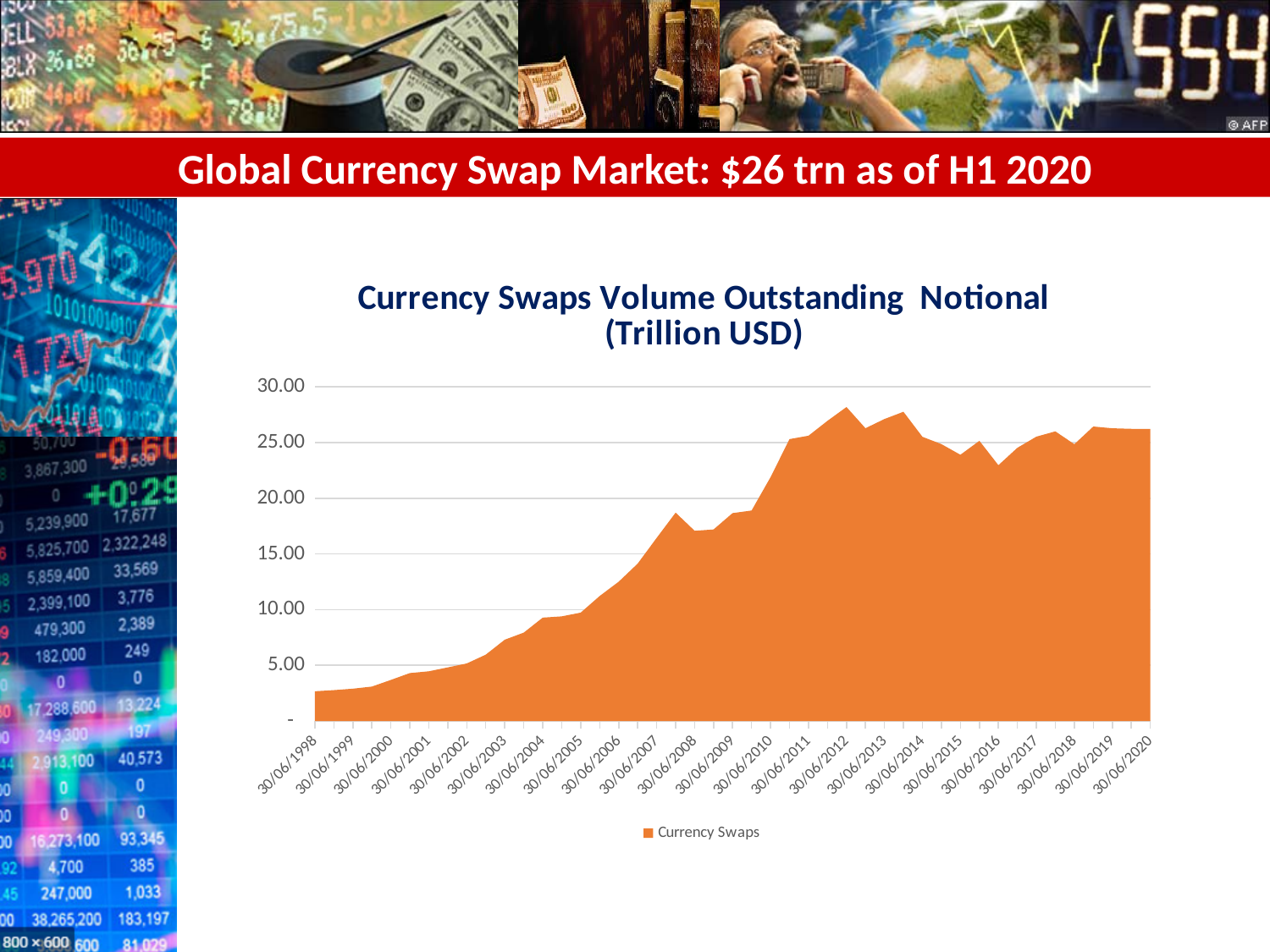
Which is larger, the value for 30/06/2016 or the value for 30/06/2017? 30/06/2017 How many series does the legend list? 1 Is the value for 30/06/1998 greater or less than 5.00? less Overall, do the values rise or fall from 30/06/1998 to 30/06/2020? Rise What is the title of the chart? Currency Swaps Volume Outstanding Notional (Trillion USD) What is the name of the series shown in the legend? Currency Swaps Is the value for 30/06/2012 greater or less than 25.00? greater Which date has the highest currency swaps volume outstanding? 30/06/2012 What type of chart is shown on the slide? Area chart Which date has the lowest currency swaps volume outstanding? 30/06/1998 Is the value for 30/06/2008 greater or less than 15.00? greater